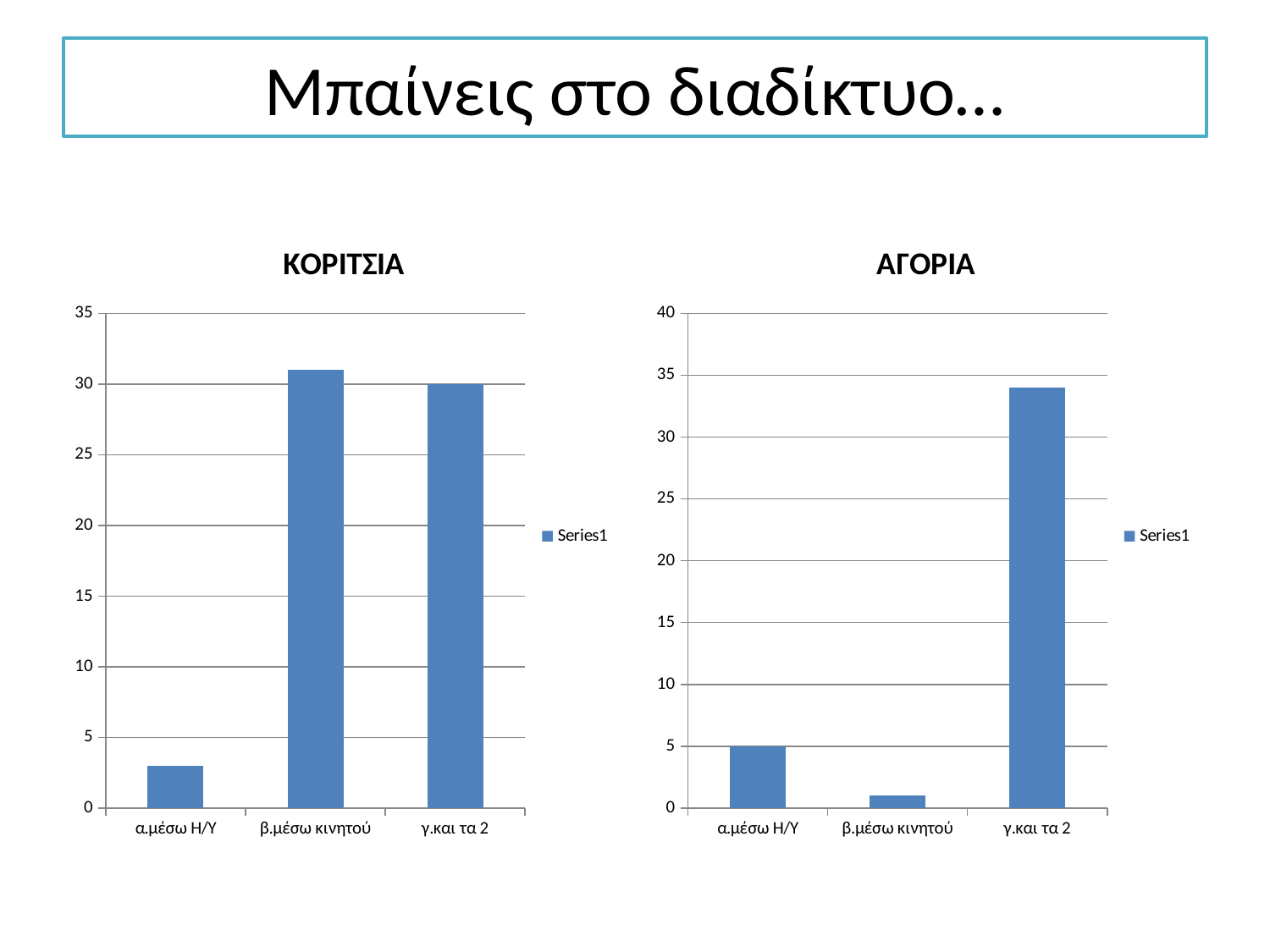
How many categories are shown on the ΑΓΟΡΙΑ chart? 3 In the ΚΟΡΙΤΣΙΑ chart, is the value for β.μέσω κινητού greater or less than 25? greater What kind of chart is the ΚΟΡΙΤΣΙΑ chart? bar chart In the ΑΓΟΡΙΑ chart, which category has the highest value? γ.και τα 2 In the ΑΓΟΡΙΑ chart, which is larger, the value for α.μέσω Η/Υ or the value for γ.και τα 2? γ.και τα 2 In the ΑΓΟΡΙΑ chart, which category has the lowest value? β.μέσω κινητού How many series does the legend of the ΚΟΡΙΤΣΙΑ chart list? 1 In the ΚΟΡΙΤΣΙΑ chart, which category has the lowest value? α.μέσω Η/Υ In the ΚΟΡΙΤΣΙΑ chart, is the value for α.μέσω Η/Υ greater or less than 5? less In the ΑΓΟΡΙΑ chart, is the value for γ.και τα 2 greater or less than 30? greater What is the title of the chart on the right side of the slide? ΑΓΟΡΙΑ In the ΑΓΟΡΙΑ chart, what is the value for α.μέσω Η/Υ? 5